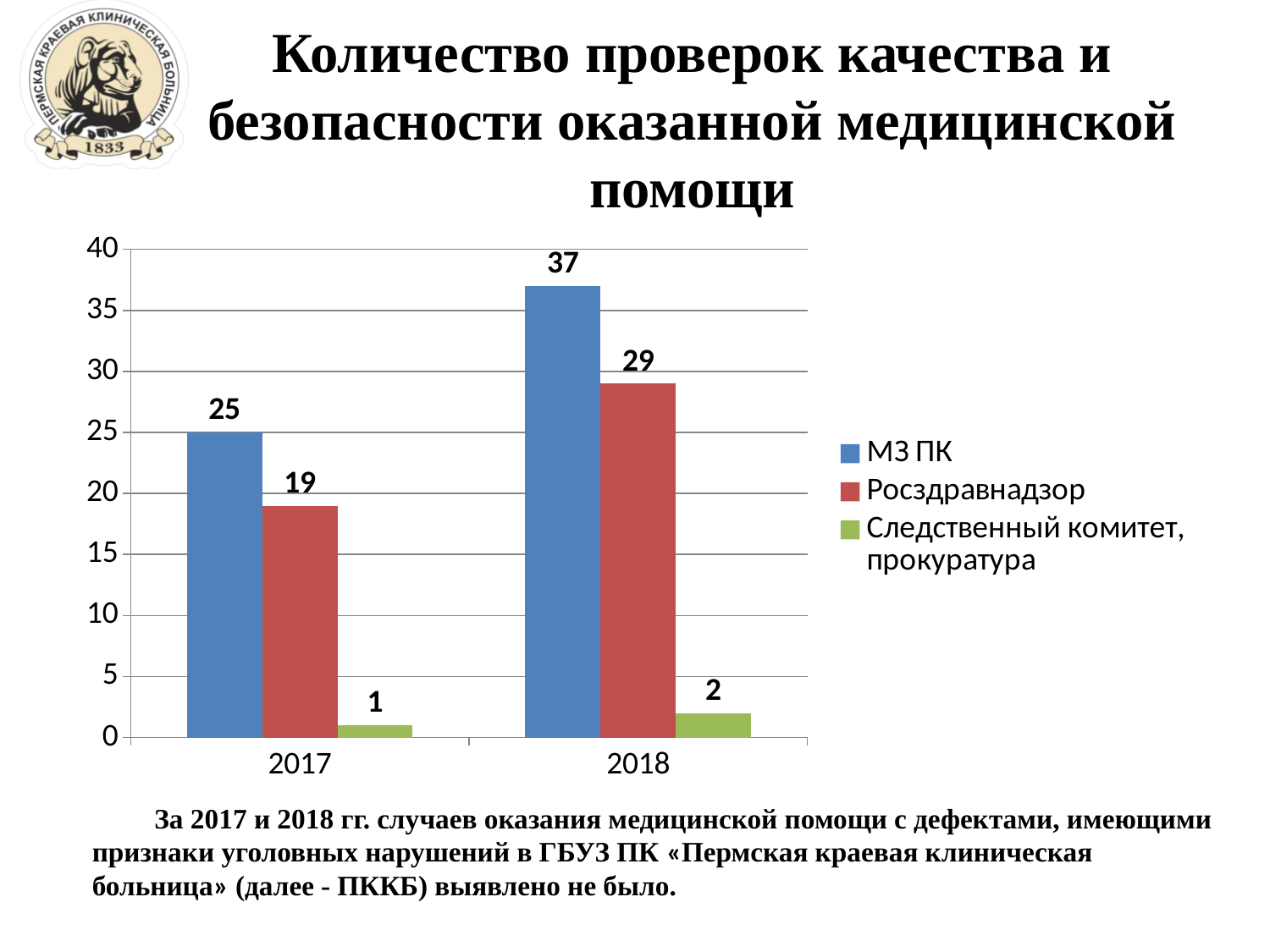
What is the difference between the МЗ ПК values for 2018 and 2017? 12 What is the difference between МЗ ПК and Росздравнадзор in 2018? 8 Which series has the highest value in 2018? МЗ ПК Which series has the lowest value in 2017? Следственный комитет, прокуратура How many series does the legend list? 3 What is the value for Следственный комитет, прокуратура in 2017? 1 Do the values for МЗ ПК rise or fall from 2017 to 2018? Rise What kind of chart is shown on the slide? Bar chart What is the value for Росздравнадзор in 2018? 29 How many year categories are shown on the x axis? 2 Which is larger: Росздравнадзор in 2017 or Росздравнадзор in 2018? Росздравнадзор in 2018 What is the value for МЗ ПК in 2017? 25